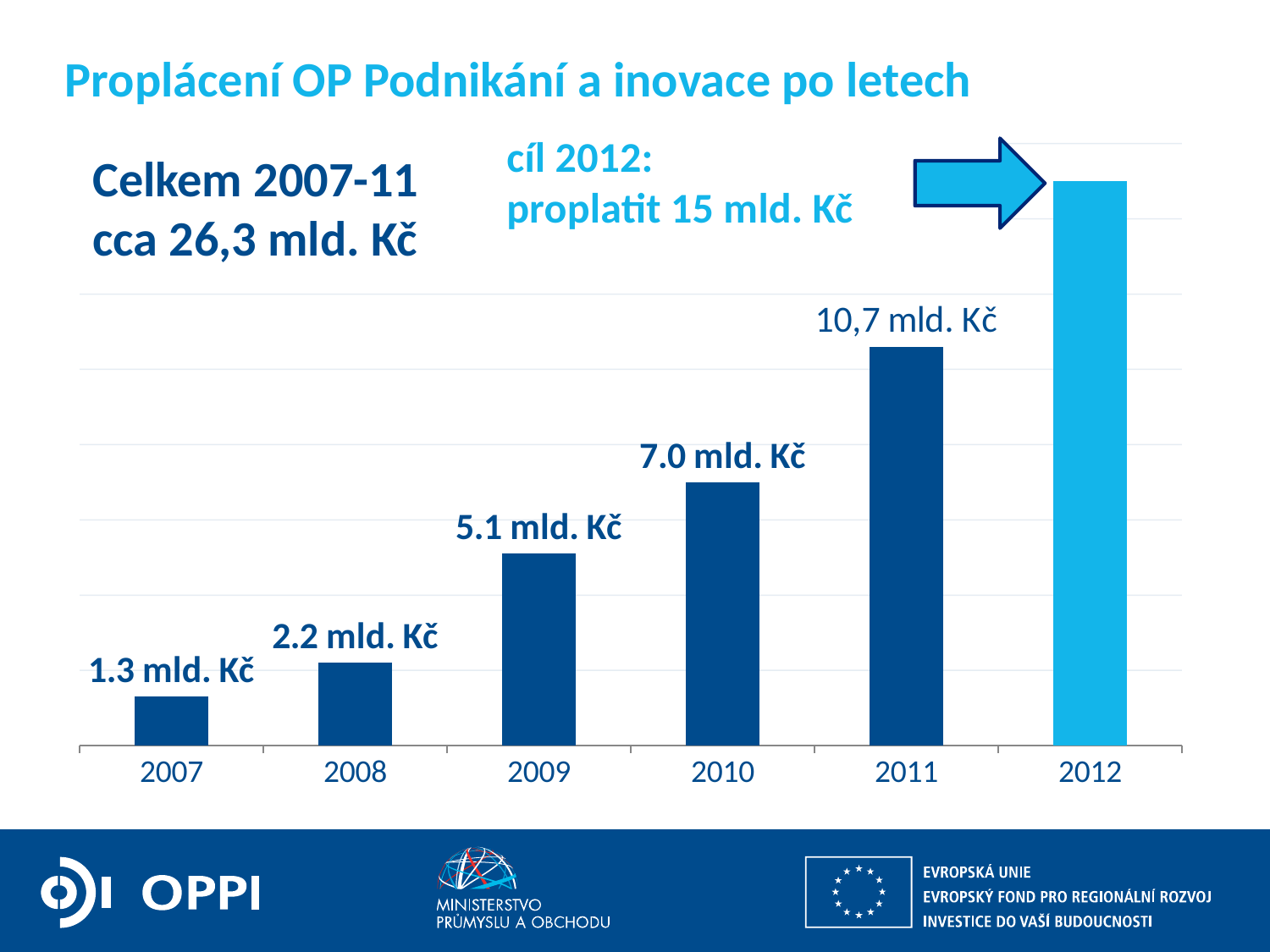
What kind of chart is shown on the slide? bar chart What value is shown for 2009? 5.1 mld. Kč How many years are shown on the x axis? 6 Do the values rise or fall from 2007 to 2012? rise What value is shown for 2011? 10,7 mld. Kč What is the difference between the values for 2008 and 2007? 0.9 mld. Kč Which year has the tallest bar? 2012 What is the difference between the values for 2010 and 2009? 1.9 mld. Kč Which year has the lowest value? 2007 Which is larger, the value for 2008 or the value for 2009? 2009 What value is shown for 2010? 7.0 mld. Kč What value is shown for 2007? 1.3 mld. Kč